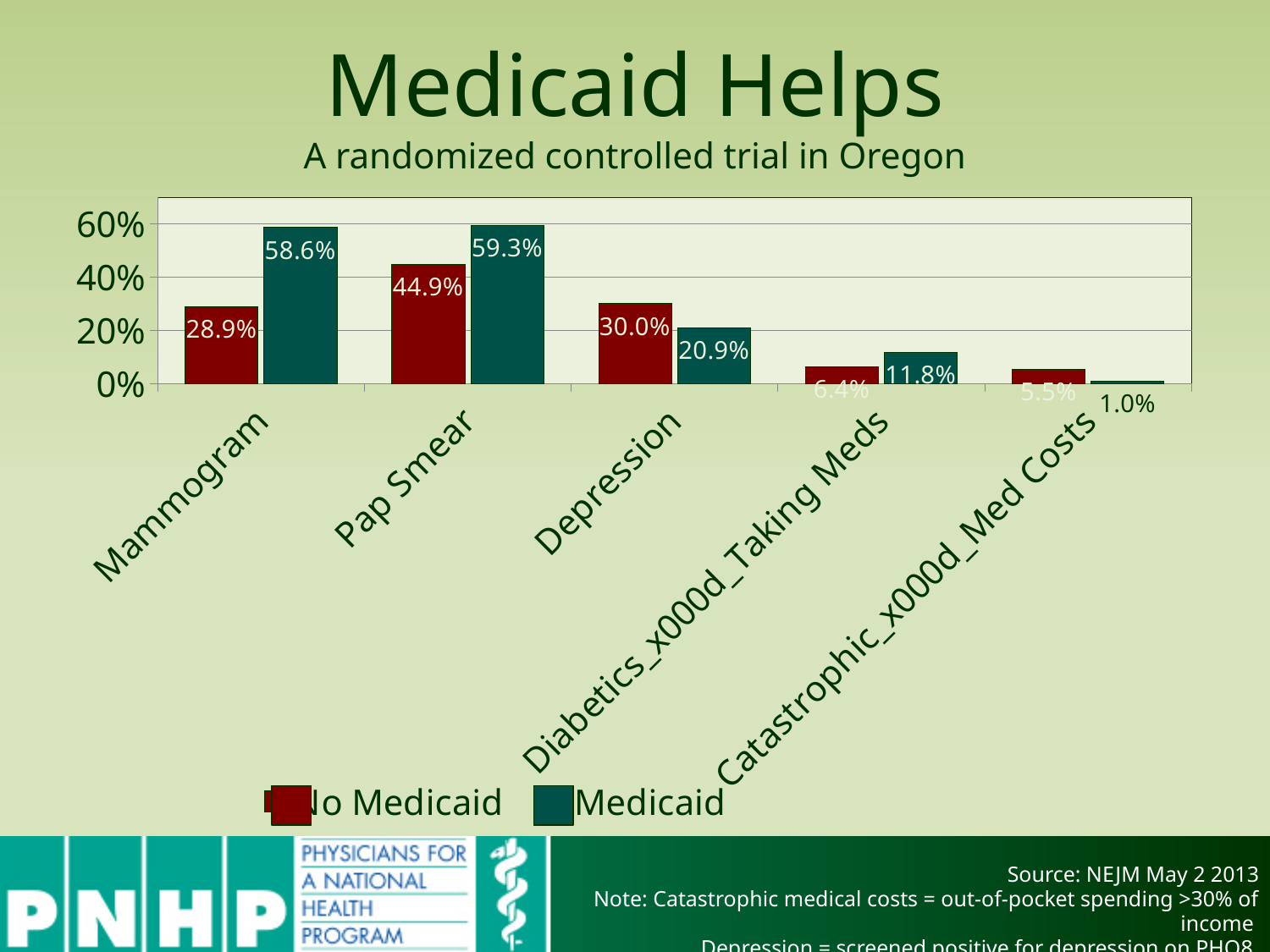
How many categories are shown on the x axis? 5 What is the Medicaid value for Mammogram? 58.6% What is the No Medicaid value for Pap Smear? 44.9% What is the Medicaid value for Depression? 20.9% Which category has the lowest No Medicaid value? Catastrophic Med Costs For Depression, which is larger: the No Medicaid value or the Medicaid value? No Medicaid What kind of chart is shown on the slide? bar chart How many series does the legend list? 2 Is the No Medicaid value for Mammogram greater or less than 40%? less What is the difference between the Medicaid and No Medicaid values for Mammogram? 29.7% Which category has the highest Medicaid value? Pap Smear What is the Medicaid value for Catastrophic Med Costs? 1.0%